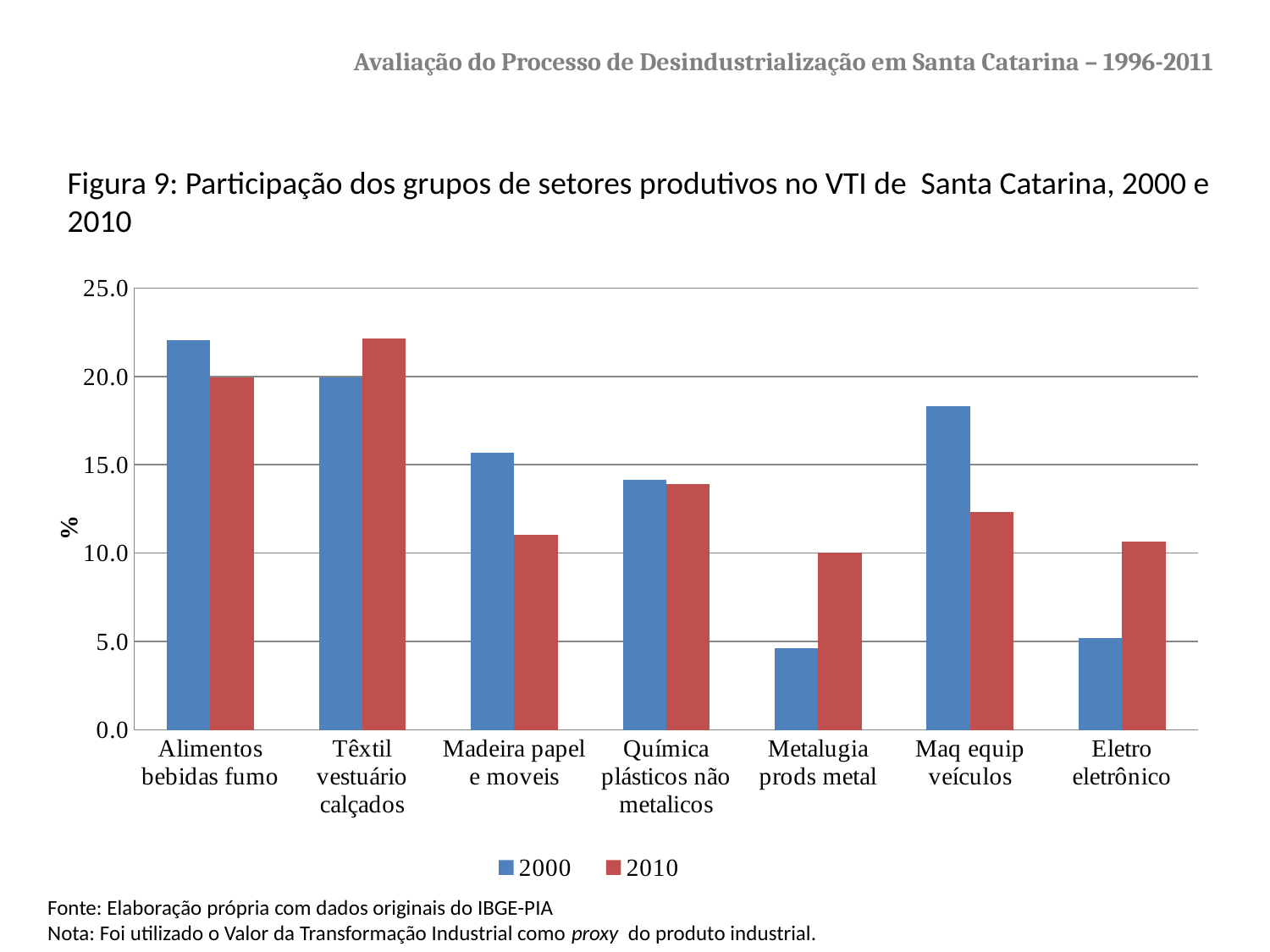
Which sector group has the highest value for 2000? Alimentos bebidas fumo Which sector group has the highest value for 2010? Têxtil vestuário calçados For Metalugia prods metal, which year has the larger value, 2000 or 2010? 2010 How many series does the legend list? 2 Is the 2000 value for Eletro eletrônico greater or less than 10.0? less How many sector groups are shown on the x axis? 7 Is the 2000 value for Maq equip veículos greater or less than 15.0? greater What label is shown on the vertical axis? % For Maq equip veículos, which year has the larger value, 2000 or 2010? 2000 What kind of chart is shown on the slide? bar chart For Madeira papel e moveis, which year has the larger value, 2000 or 2010? 2000 Which sector group has the lowest value for 2000? Metalugia prods metal